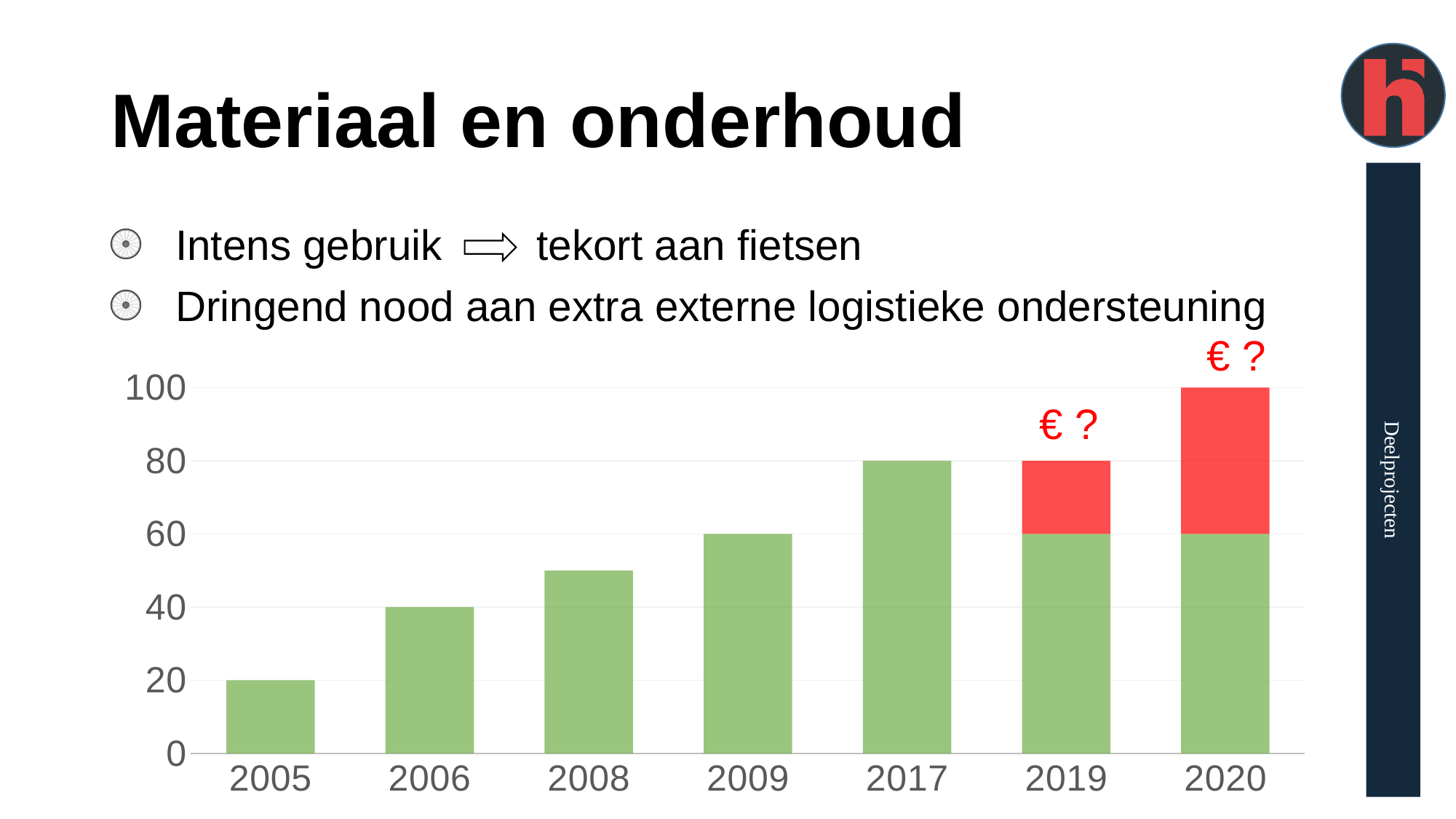
What type of chart is shown on the slide? bar chart What is the difference between the bar for 2017 and the bar for 2005? 60 What is the total height of the stacked bar for 2020? 100 Do the bar heights rise or fall from 2005 to 2020? rise Which year has the lowest bar in the chart? 2005 What is the value of the bar for 2006? 40 What is the value of the bar for 2005? 20 What is the total height of the stacked bar for 2019? 80 How many years are shown on the x axis of the chart? 7 Is the value for 2008 greater or less than 40? greater What is the value of the bar for 2017? 80 Which year has the highest bar in the chart? 2020